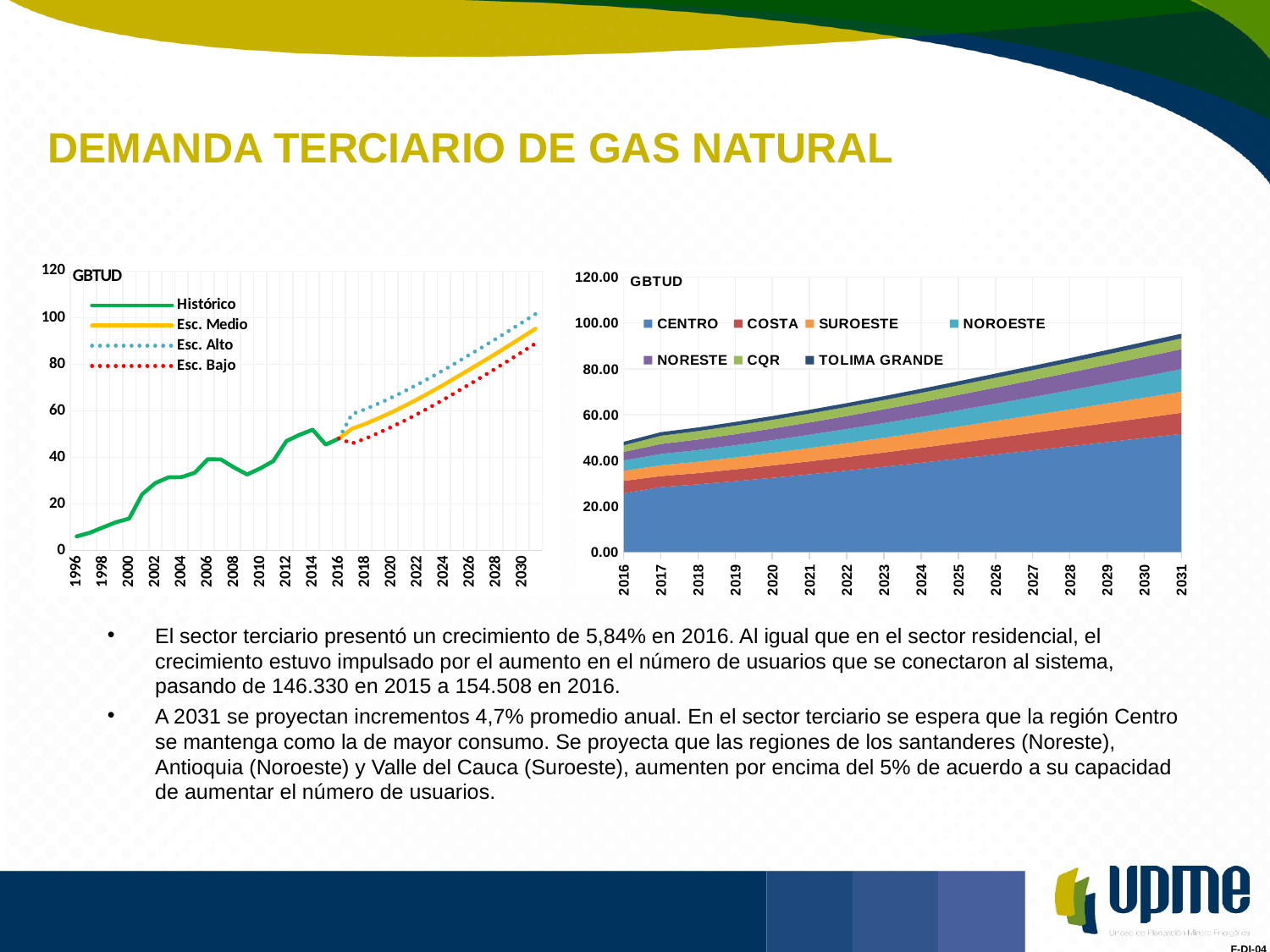
In the right chart, is the total stacked value for 2031 greater or less than 80.00? greater What kind of chart is the left chart on the slide? line chart In the left chart, which series is drawn as a solid green line? Histórico How many series does the legend of the left chart list? 4 In the left chart, is the Esc. Bajo value for 2030 greater or less than 100? less In the left chart, is the Histórico value for 1996 greater or less than 20? less What kind of chart is the right chart on the slide? stacked area chart How many series does the legend of the right chart list? 7 In the right chart, how many years are shown on the x axis? 16 In the left chart, which is larger in 2030, Esc. Alto or Esc. Bajo? Esc. Alto What unit label appears at the top of the y axis in both charts? GBTUD In the right chart, which region has the largest share of demand across the years shown? CENTRO